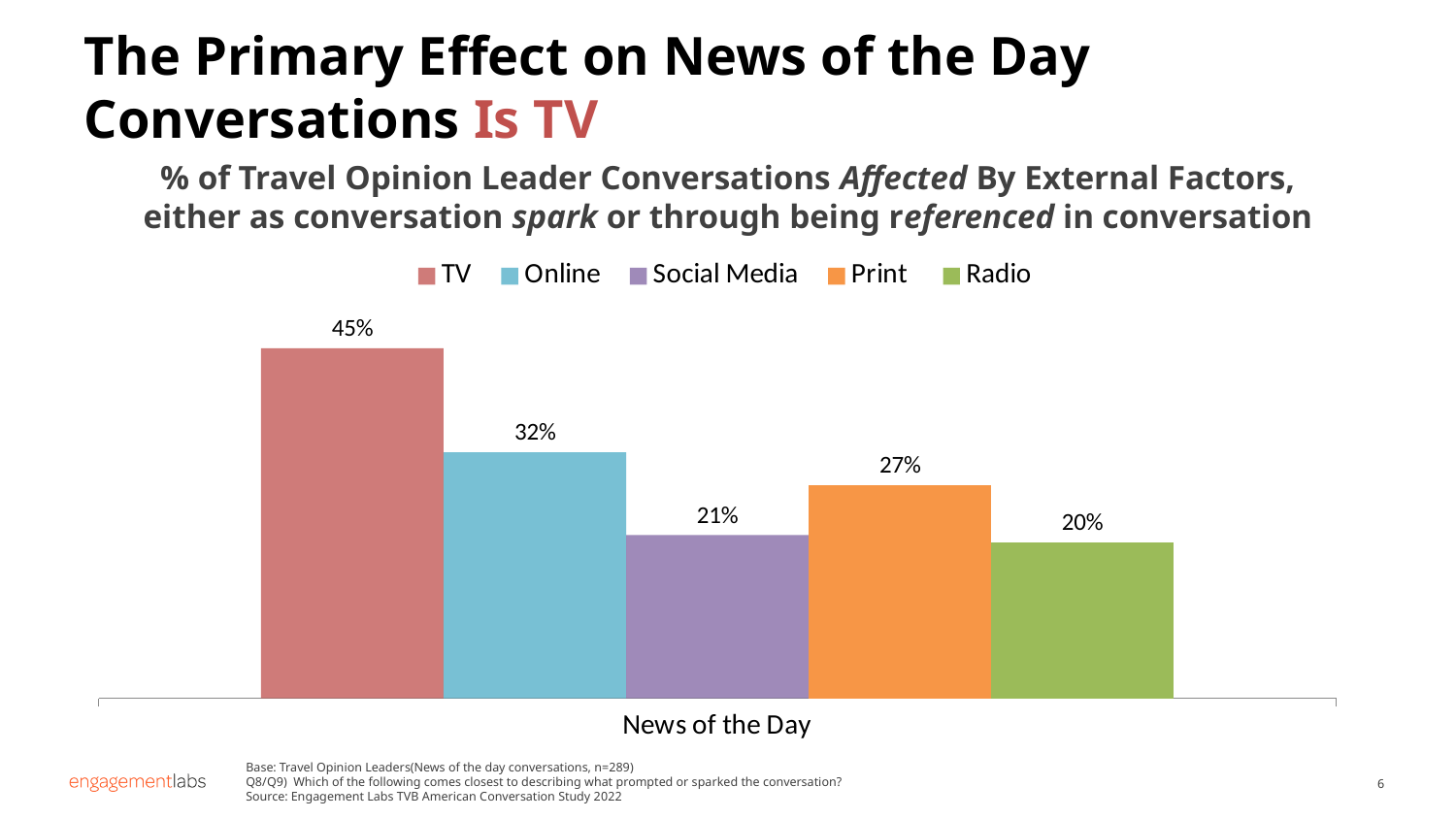
How many series does the legend list? 5 What percentage is shown for Print? 27% Which series has the lowest value? Radio What percentage is shown for Social Media? 21% What kind of chart is shown on the slide? Bar chart What is the difference between the Print value and the Radio value? 7% What colour is the bar for Print? Orange Which is larger, the value for Online or the value for Print? Online What is the category label shown on the x axis? News of the Day What is the difference between the TV value and the Online value? 13% Which series has the highest value? TV What percentage is shown for TV? 45%